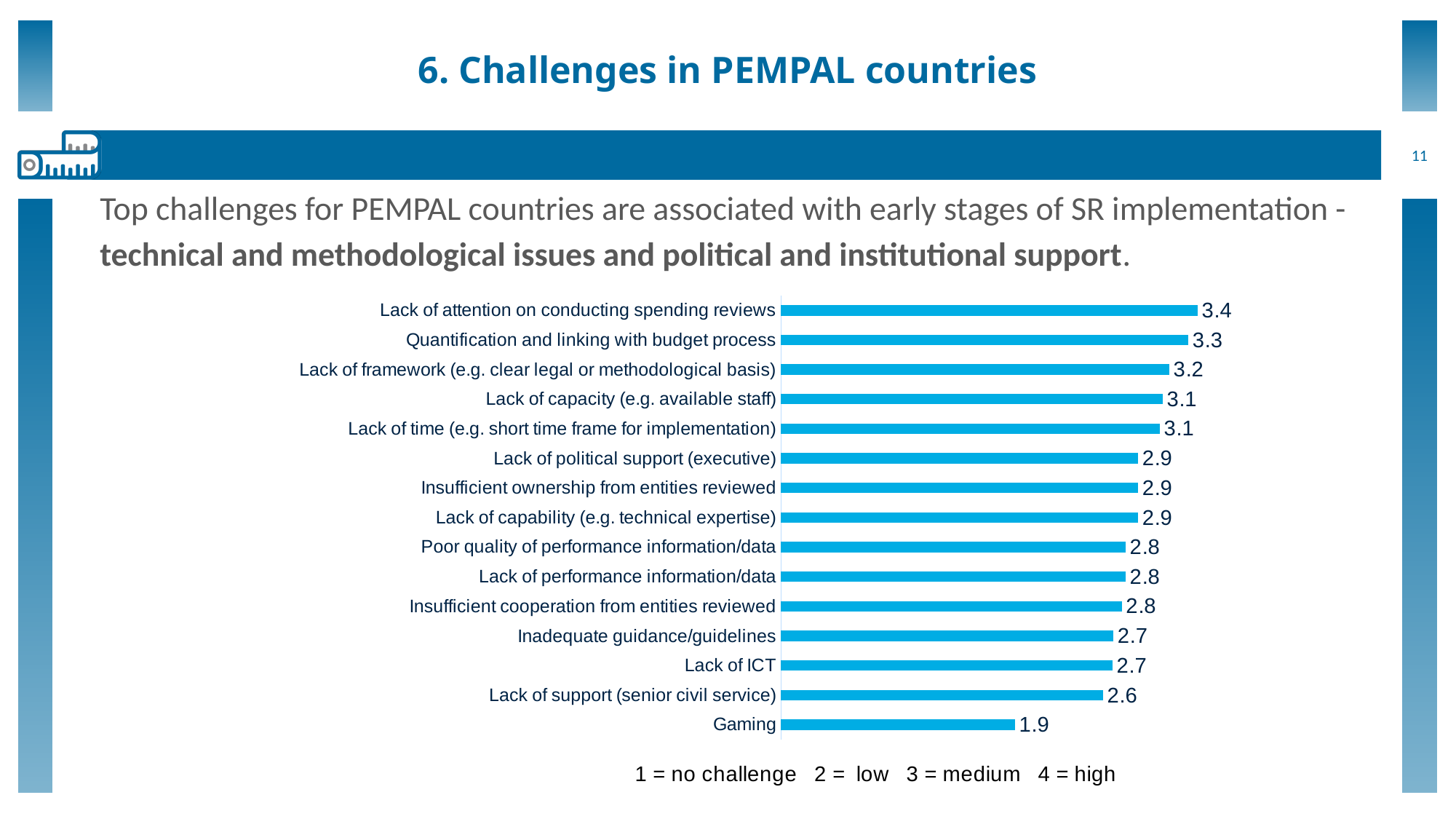
What kind of chart is shown on the slide? Bar chart Which has a larger value, "Lack of framework (e.g. clear legal or methodological basis)" or "Inadequate guidance/guidelines"? Lack of framework (e.g. clear legal or methodological basis) What is the difference between the values for "Quantification and linking with budget process" and "Lack of support (senior civil service)"? 0.7 How many categories are shown in the chart? 15 What is the value for "Lack of support (senior civil service)"? 2.6 What is the value for "Gaming"? 1.9 What is the value for "Lack of ICT"? 2.7 Which category has the lowest value? Gaming What is the difference between the values for "Lack of attention on conducting spending reviews" and "Gaming"? 1.5 Which category has the highest value? Lack of attention on conducting spending reviews According to the scale note below the chart, what does a value of 4 represent? high What is the value for "Lack of attention on conducting spending reviews"? 3.4